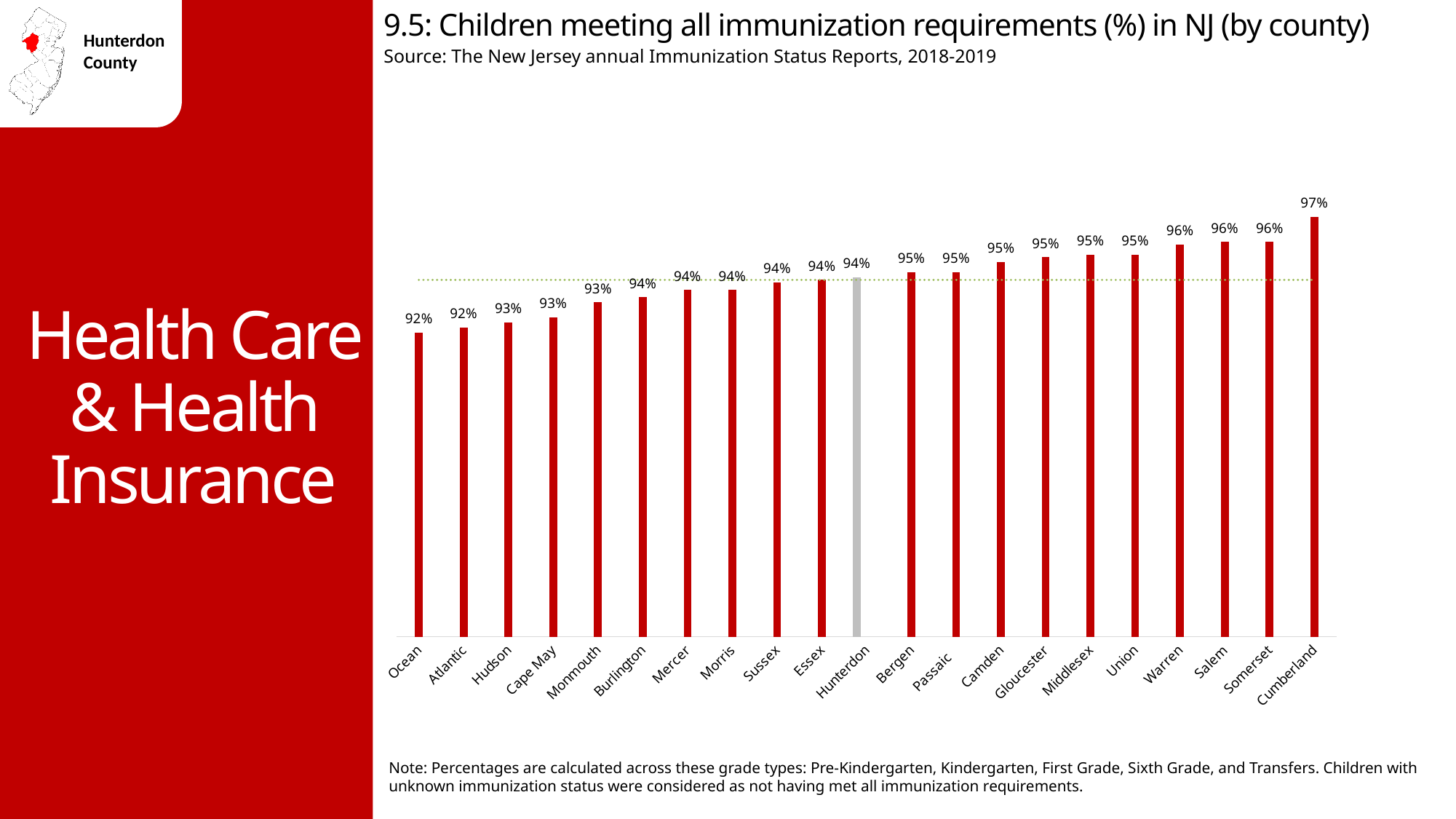
What is the value shown for Warren County? 96% What kind of chart is shown on the slide? Bar chart What is the difference in percentage points between Cumberland and Ocean counties? 5 percentage points What is the value shown for Cumberland County? 97% Which county has the highest percentage of children meeting all immunization requirements? Cumberland What is the value shown for Ocean County? 92% What percentage is shown for Bergen County? 95% Which has a higher value, Hunterdon or Ocean? Hunterdon What is the difference in percentage points between Cumberland and Hunterdon counties? 3 percentage points Do the values rise or fall moving from left to right across the counties? Rise How many counties are shown on the chart? 21 What percentage of children in Hunterdon County met all immunization requirements? 94%